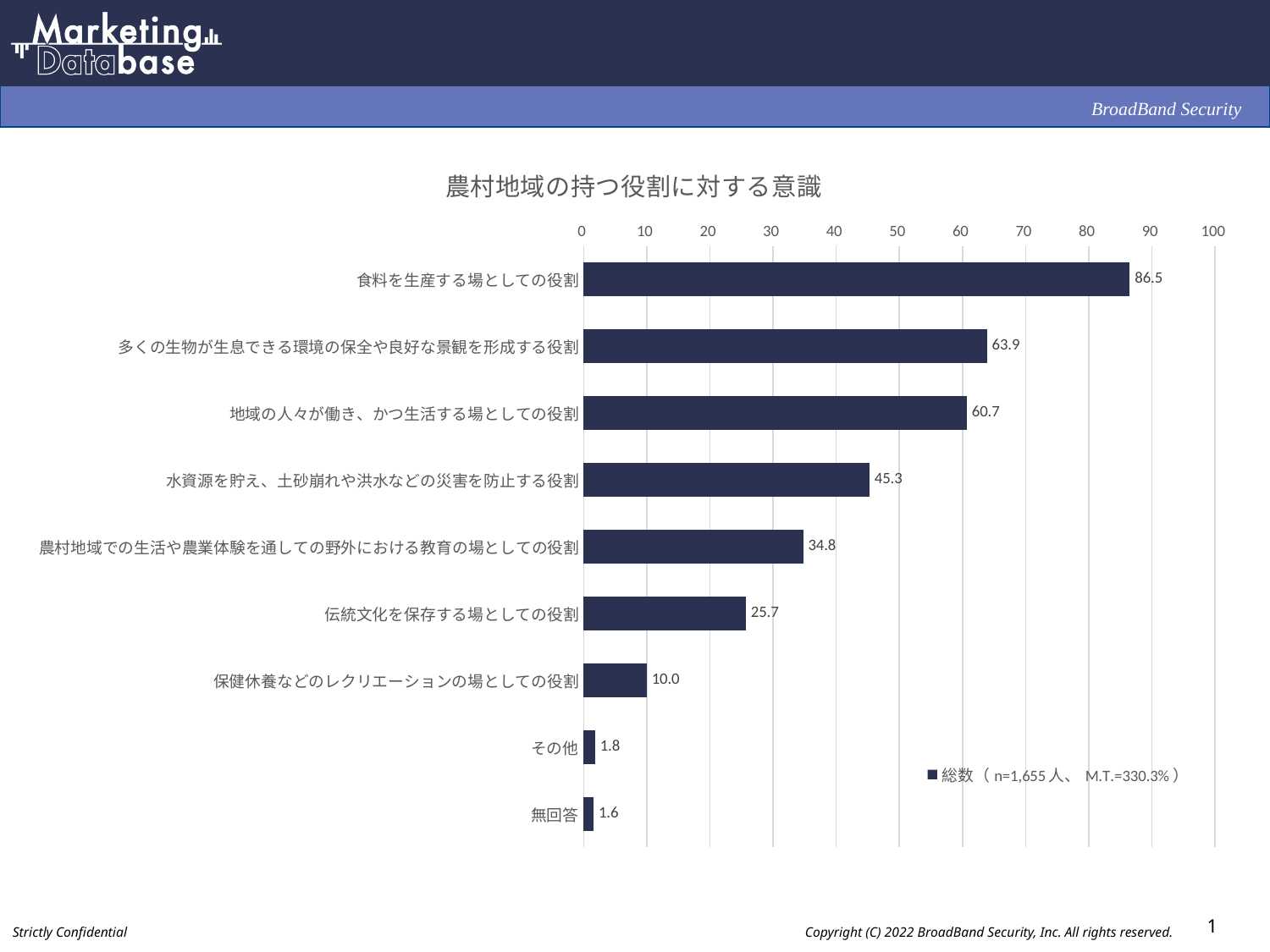
What is the difference between the values for 多くの生物が生息できる環境の保全や良好な景観を形成する役割 and 地域の人々が働き、かつ生活する場としての役割? 3.2 What kind of chart is shown on the slide? bar chart What is the value for 伝統文化を保存する場としての役割? 25.7 How many series does the legend list? 1 Which category has the lowest value? 無回答 Which is larger: the value for 水資源を貯え、土砂崩れや洪水などの災害を防止する役割 or the value for 農村地域での生活や農業体験を通しての野外における教育の場としての役割? 水資源を貯え、土砂崩れや洪水などの災害を防止する役割 What is the value for 食料を生産する場としての役割? 86.5 What is the value for 無回答? 1.6 Is the value for 保健休養などのレクリエーションの場としての役割 greater or less than 20? less How many categories are shown in the chart? 9 Which category has the highest value? 食料を生産する場としての役割 What is the title of the chart? 農村地域の持つ役割に対する意識